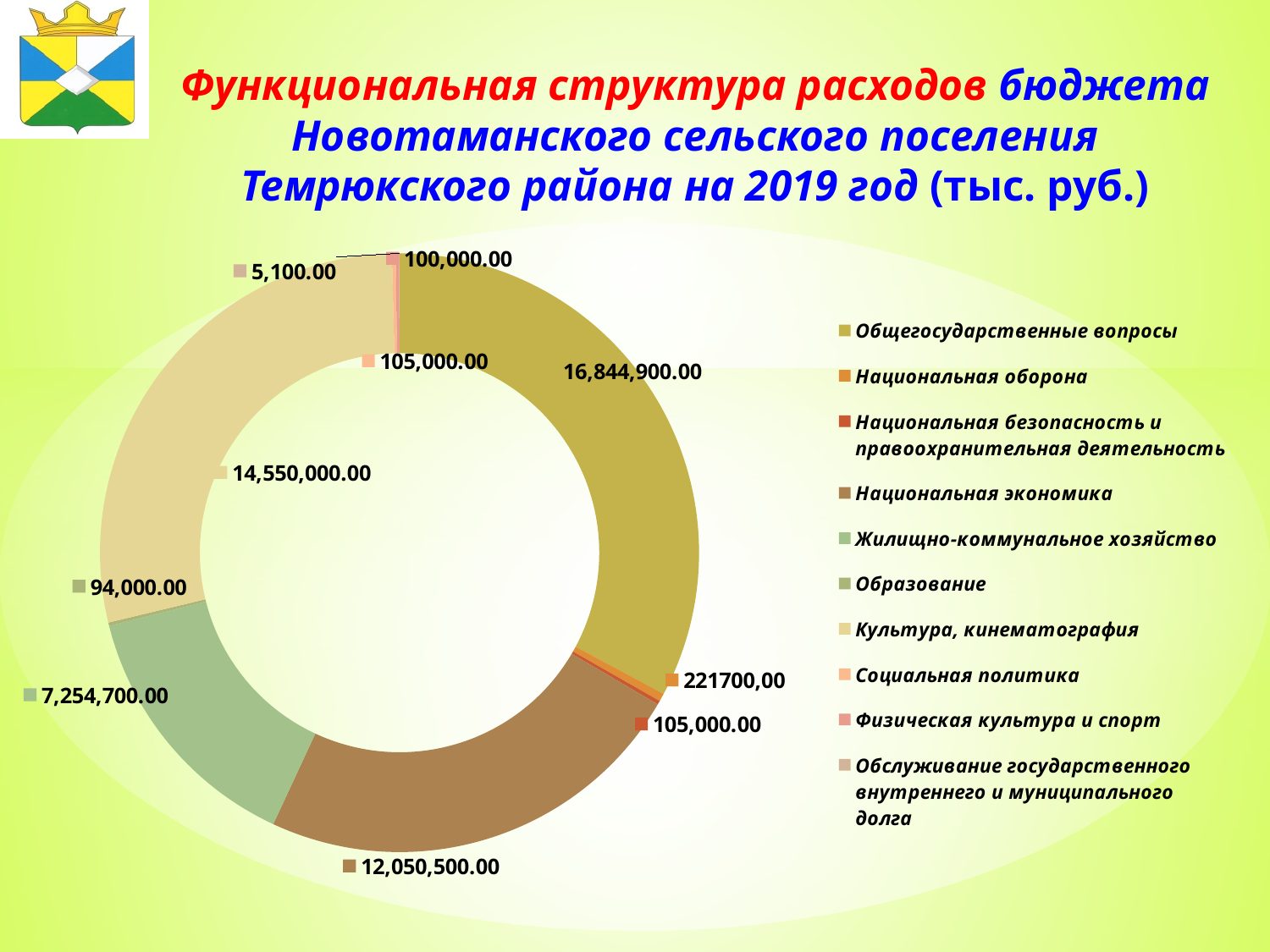
What is the value for Общегосударственные вопросы? 16,844,900.00 Which category has the largest share of the chart? Общегосударственные вопросы Which category has the smallest value? Обслуживание государственного внутреннего и муниципального долга What is the difference between the values for Общегосударственные вопросы and Культура, кинематография? 2,294,900.00 What is the value for Национальная экономика? 12,050,500.00 What is the value for Жилищно-коммунальное хозяйство? 7,254,700.00 What year does the chart title refer to? 2019 What kind of chart is shown on the slide? doughnut chart How many categories does the chart show? 10 What is the value for Образование? 94,000.00 Which is larger: Национальная экономика or Жилищно-коммунальное хозяйство? Национальная экономика What is the value for Культура, кинематография? 14,550,000.00